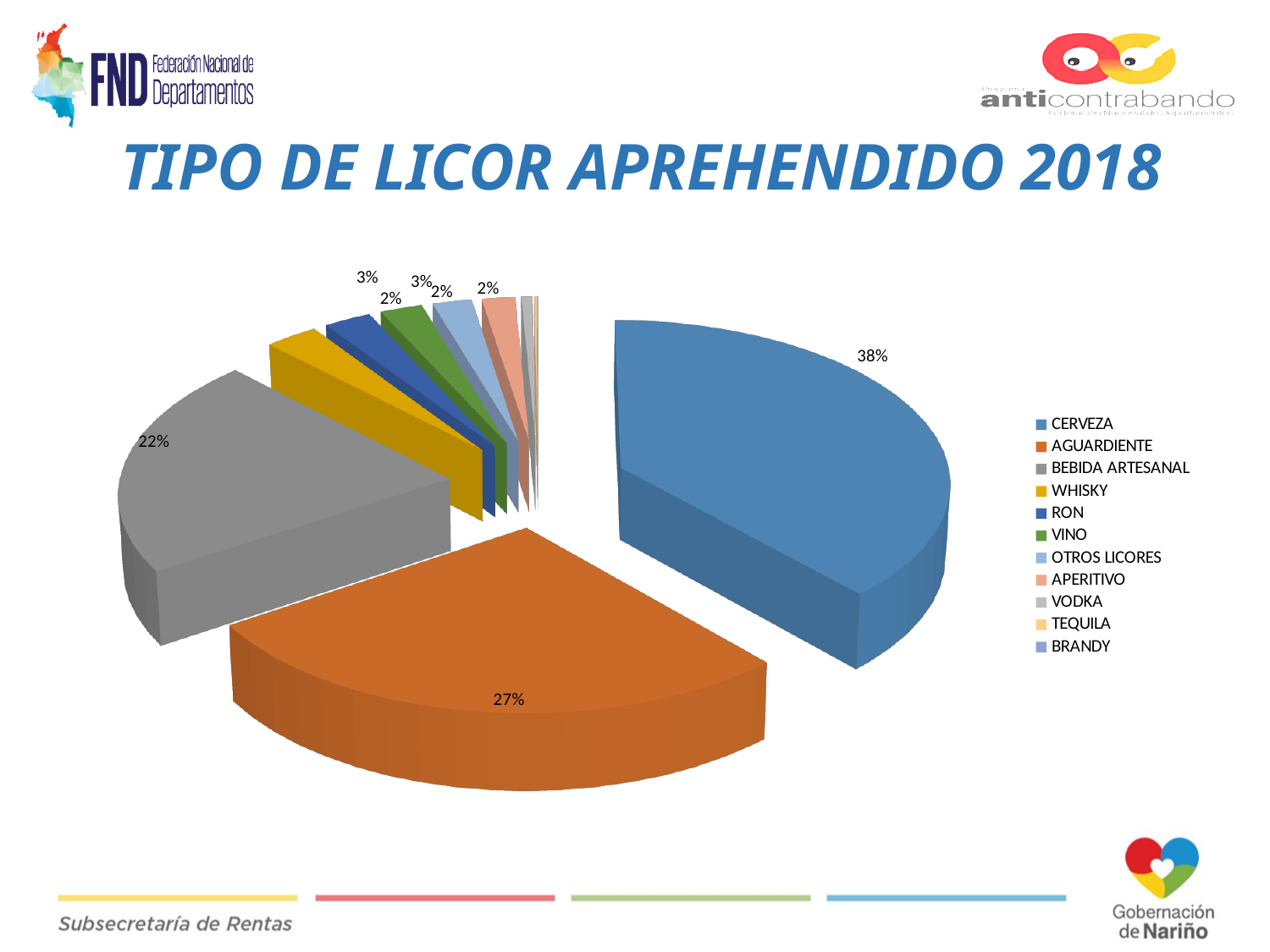
What percentage is shown for AGUARDIENTE? 27% What is the difference between the AGUARDIENTE and BEBIDA ARTESANAL shares? 5% What percentage of the pie does CERVEZA represent? 38% What share of the pie is BEBIDA ARTESANAL? 22% Which type of liquor has the largest slice of the pie? CERVEZA What is the title of the chart? TIPO DE LICOR APREHENDIDO 2018 What kind of chart is shown on the slide? Pie chart What percentage is labelled for WHISKY? 3% Which category is shown in orange in the legend? AGUARDIENTE Which is larger, the share for AGUARDIENTE or for BEBIDA ARTESANAL? AGUARDIENTE What is the difference in percentage points between CERVEZA and AGUARDIENTE? 11% How many categories are listed in the legend? 11